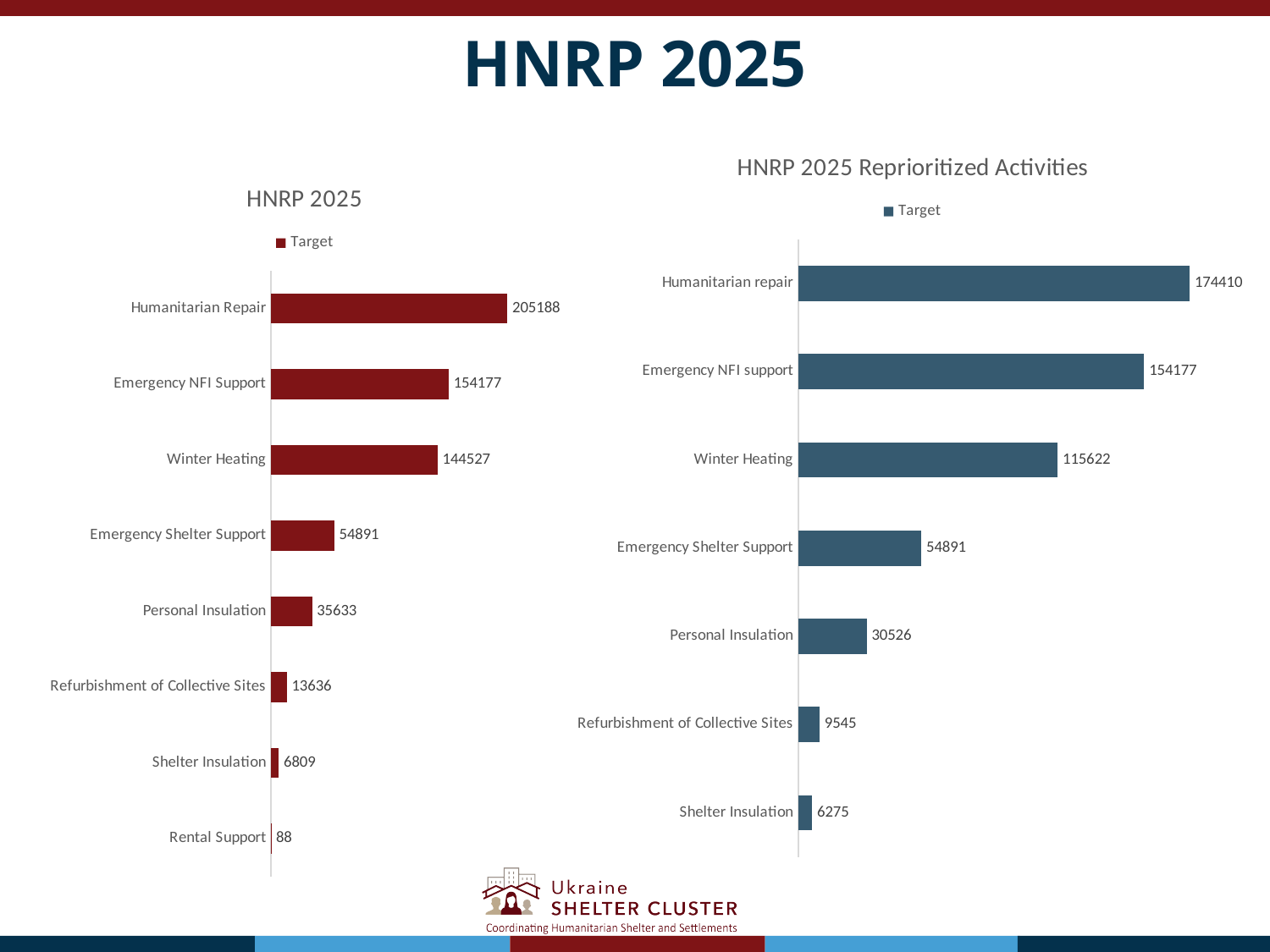
In the 'HNRP 2025 Reprioritized Activities' chart, which category has the highest Target value? Humanitarian repair In the 'HNRP 2025' chart, which category has the lowest Target value? Rental Support In the 'HNRP 2025 Reprioritized Activities' chart, what is the difference between the Target values for Personal Insulation and Refurbishment of Collective Sites? 20981 In the 'HNRP 2025' chart, which is larger: the Target for Winter Heating or for Emergency Shelter Support? Winter Heating How many series does the legend of the 'HNRP 2025 Reprioritized Activities' chart list? 1 How many categories are shown in the 'HNRP 2025 Reprioritized Activities' chart? 7 In the 'HNRP 2025' chart, what is the Target value for Humanitarian Repair? 205188 How many categories are shown in the 'HNRP 2025' chart? 8 What is the name of the series shown in the legend of the 'HNRP 2025' chart? Target In the 'HNRP 2025' chart, what is the difference between the Target values for Humanitarian Repair and Emergency NFI Support? 51011 What kind of chart is the 'HNRP 2025' chart? Bar chart In the 'HNRP 2025 Reprioritized Activities' chart, what is the Target value for Winter Heating? 115622